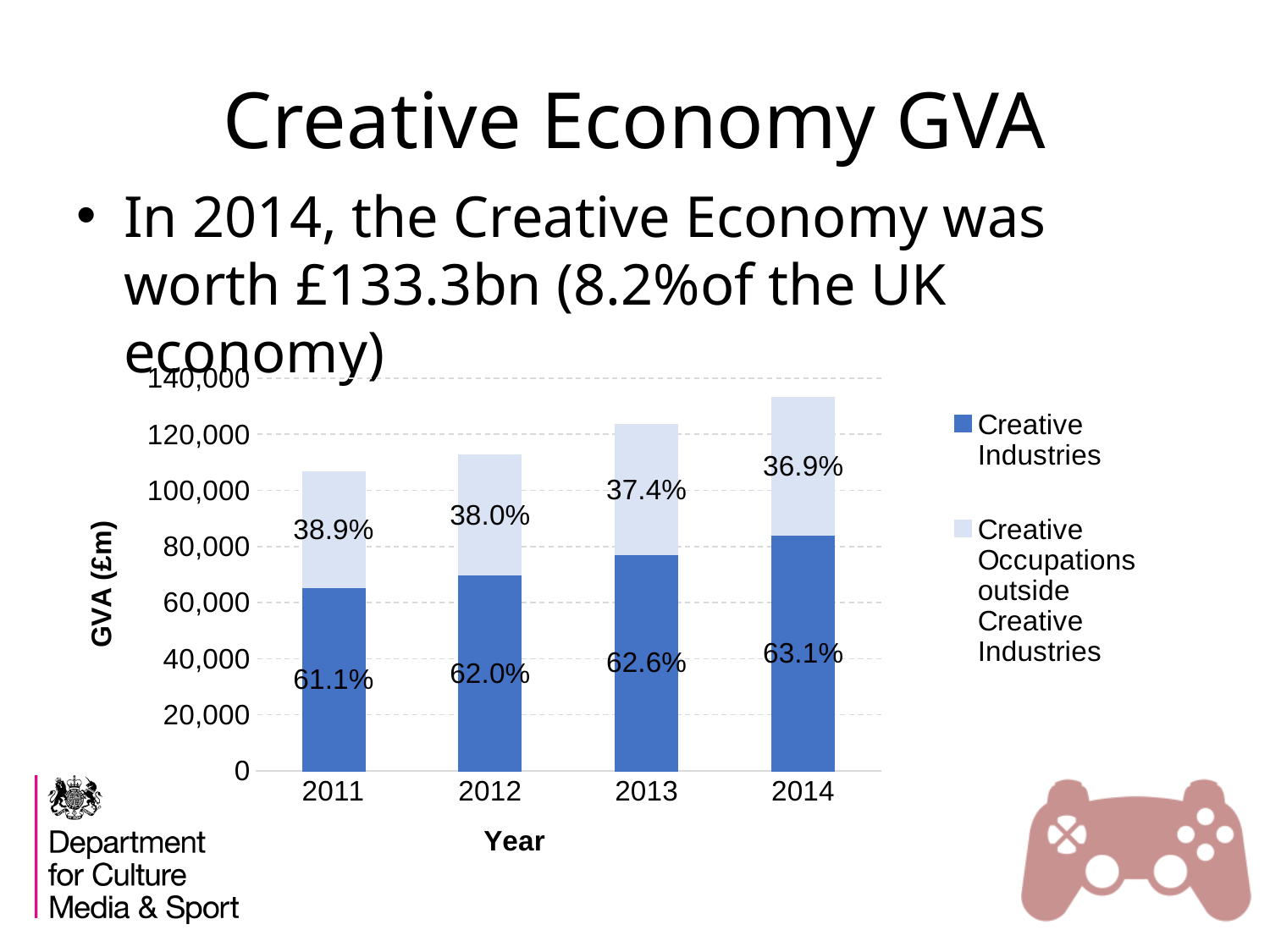
What percentage label is shown on the Creative Industries segment for 2012? 62.0% Is the total GVA bar for 2014 greater or less than 120,000? greater In which year is the Creative Occupations outside Creative Industries percentage label the lowest? 2014 By how many percentage points does the Creative Industries label in 2014 exceed the one in 2011? 2.0 percentage points What percentage label is shown on the Creative Occupations outside Creative Industries segment for 2011? 38.9% How many series does the legend list? 2 What percentage label is shown on the Creative Industries segment for 2014? 63.1% Which is larger: the Creative Occupations outside Creative Industries label in 2012 or in 2013? 2012 In which year is the Creative Industries percentage label the highest? 2014 What kind of chart is shown on the slide? Stacked bar chart Is the total GVA bar for 2012 greater or less than 120,000? less How many years are shown on the x axis? 4